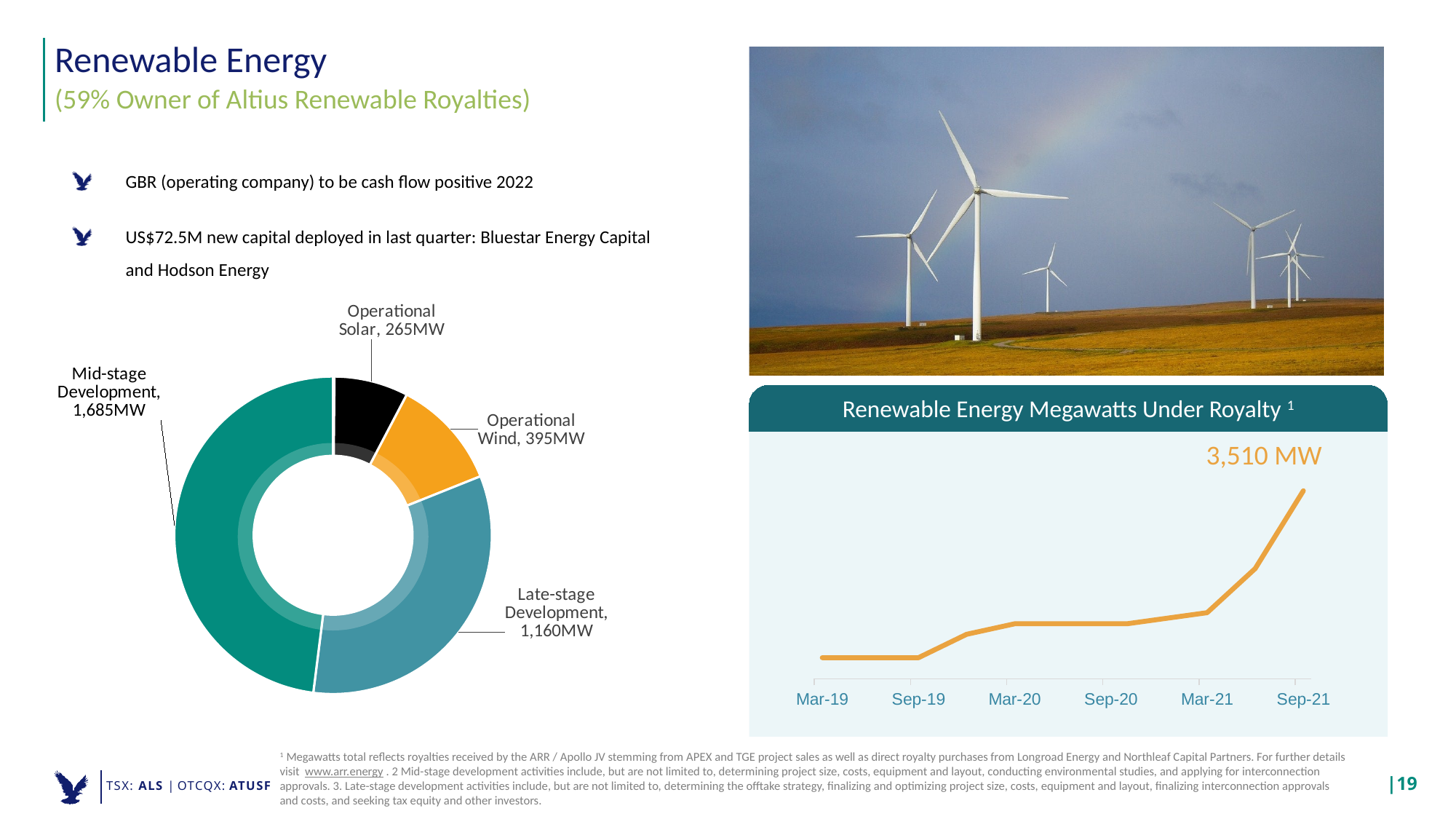
In the donut chart on the left, how many megawatts are shown for Operational Solar? 265MW What kind of chart is 'Renewable Energy Megawatts Under Royalty'? Line chart In the donut chart on the left, how many megawatts are shown for Operational Wind? 395MW In the donut chart on the left, which category has the largest value? Mid-stage Development In the 'Renewable Energy Megawatts Under Royalty' chart, what value is labelled at Sep-21? 3,510 MW In the donut chart on the left, which is larger: Operational Wind or Operational Solar? Operational Wind In the donut chart on the left, what is the difference in megawatts between Mid-stage Development and Late-stage Development? 525MW In the 'Renewable Energy Megawatts Under Royalty' chart, do the values rise or fall from Mar-19 to Sep-21? Rise How many date labels are shown on the x axis of the 'Renewable Energy Megawatts Under Royalty' chart? 6 In the donut chart on the left, how many megawatts are shown for Late-stage Development? 1,160MW